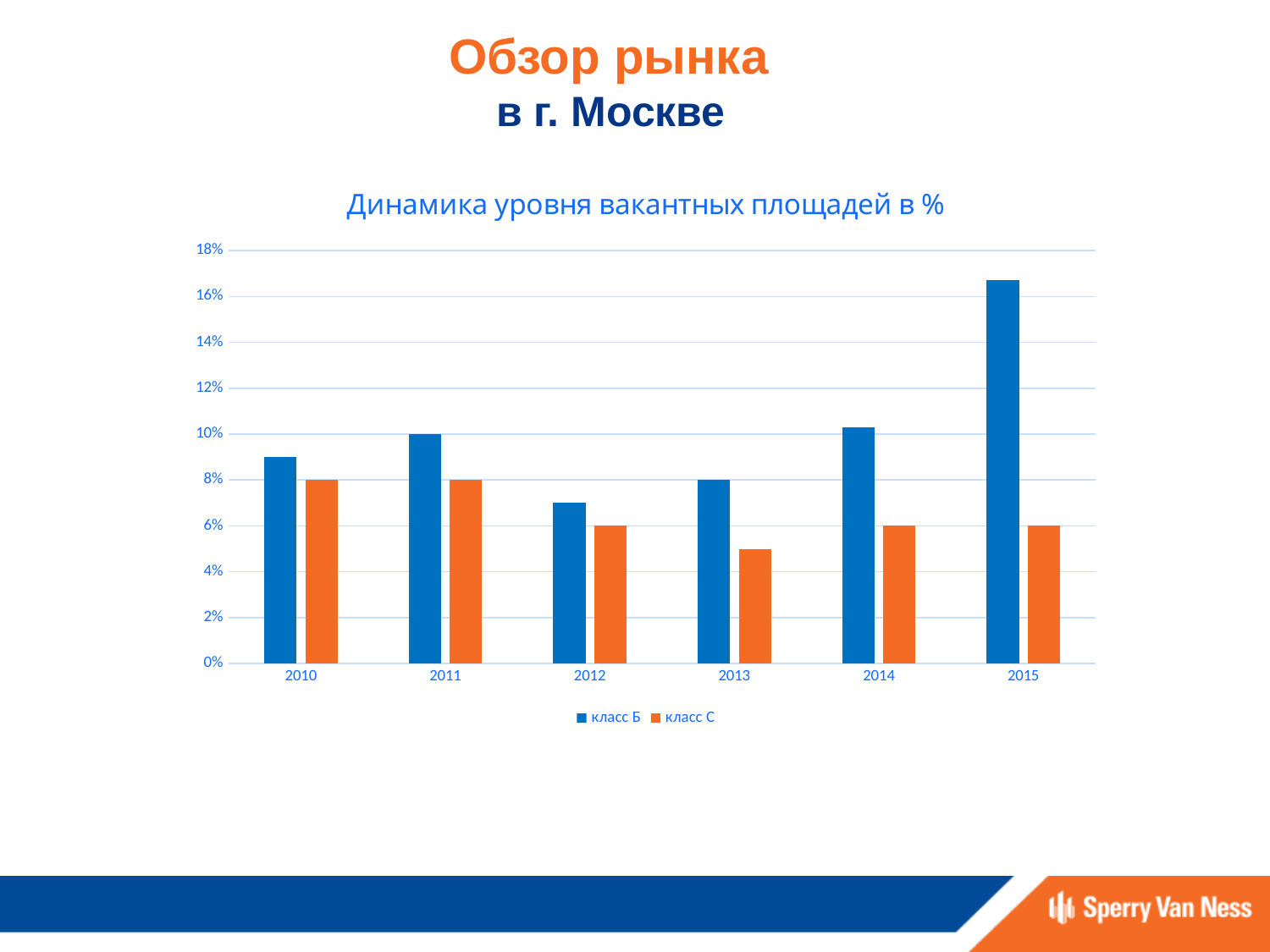
How many years are shown on the x axis? 6 Is the value for класс Б in 2015 greater or less than 16%? greater What kind of chart is shown on the slide? bar chart What is the difference between класс Б and класс С in 2011? 2% How many series does the legend list? 2 What is the value for класс С in 2014? 6% In which year is the value for класс С lowest? 2013 In which year is the value for класс Б highest? 2015 What is the value for класс С in 2010? 8% What is the title of the chart? Динамика уровня вакантных площадей в % What is the value for класс Б in 2011? 10% Which is larger in 2014, класс Б or класс С? класс Б